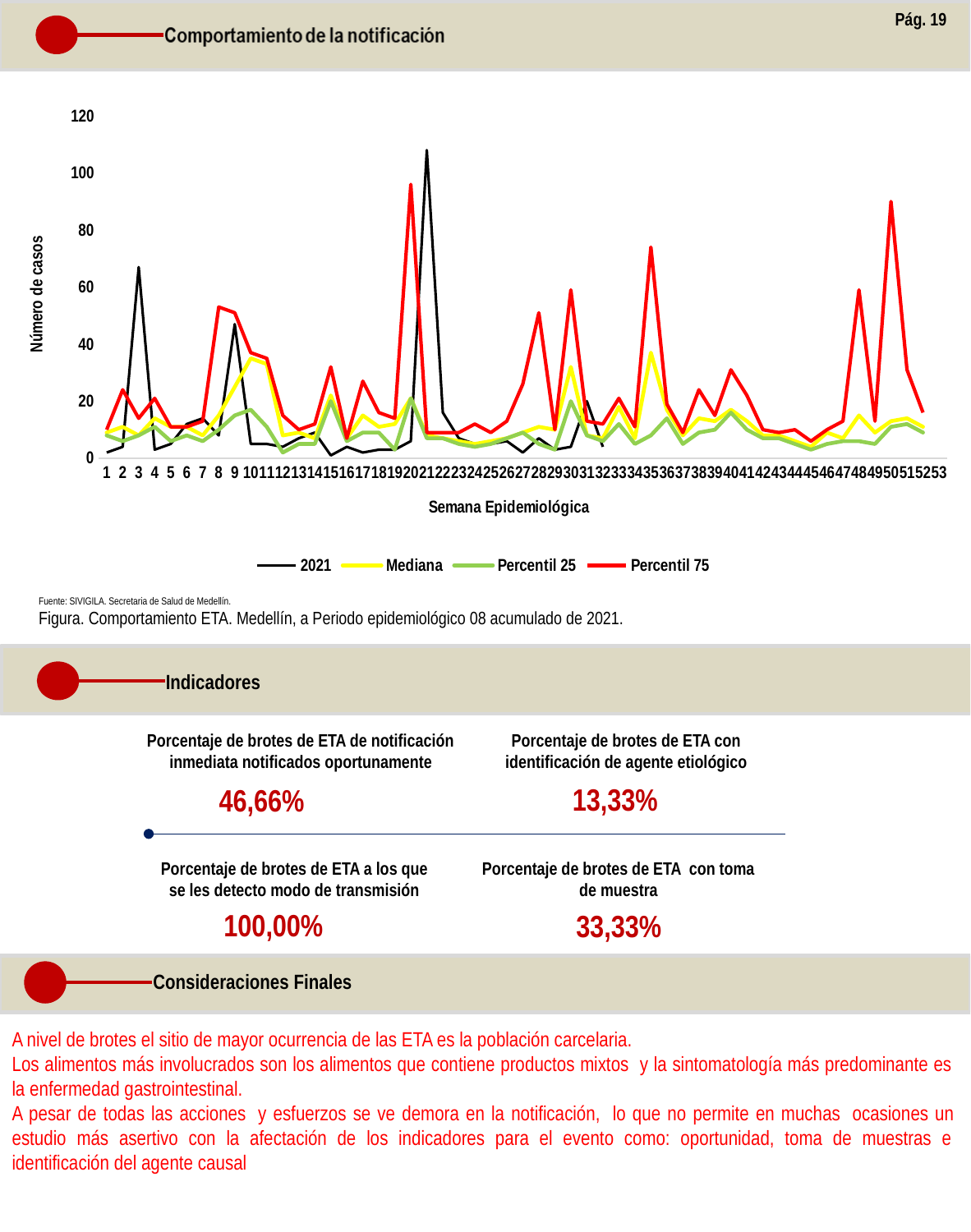
Is the value of the Percentil 75 series at week 50 greater or less than 80? greater Is the value of the Percentil 25 series at week 20 greater or less than 40? less What kind of chart is shown on the slide? line chart How many series does the chart legend list? 4 What is the title of the y axis of the chart? Número de casos What is the title of the x axis of the chart? Semana Epidemiológica How many epidemiological weeks are shown on the x axis of the chart? 53 At week 21, which series has the larger value, 2021 or Percentil 75? 2021 Is the value of the 2021 series at week 21 greater or less than 100? greater In which epidemiological week does the 2021 series reach its highest value? 21